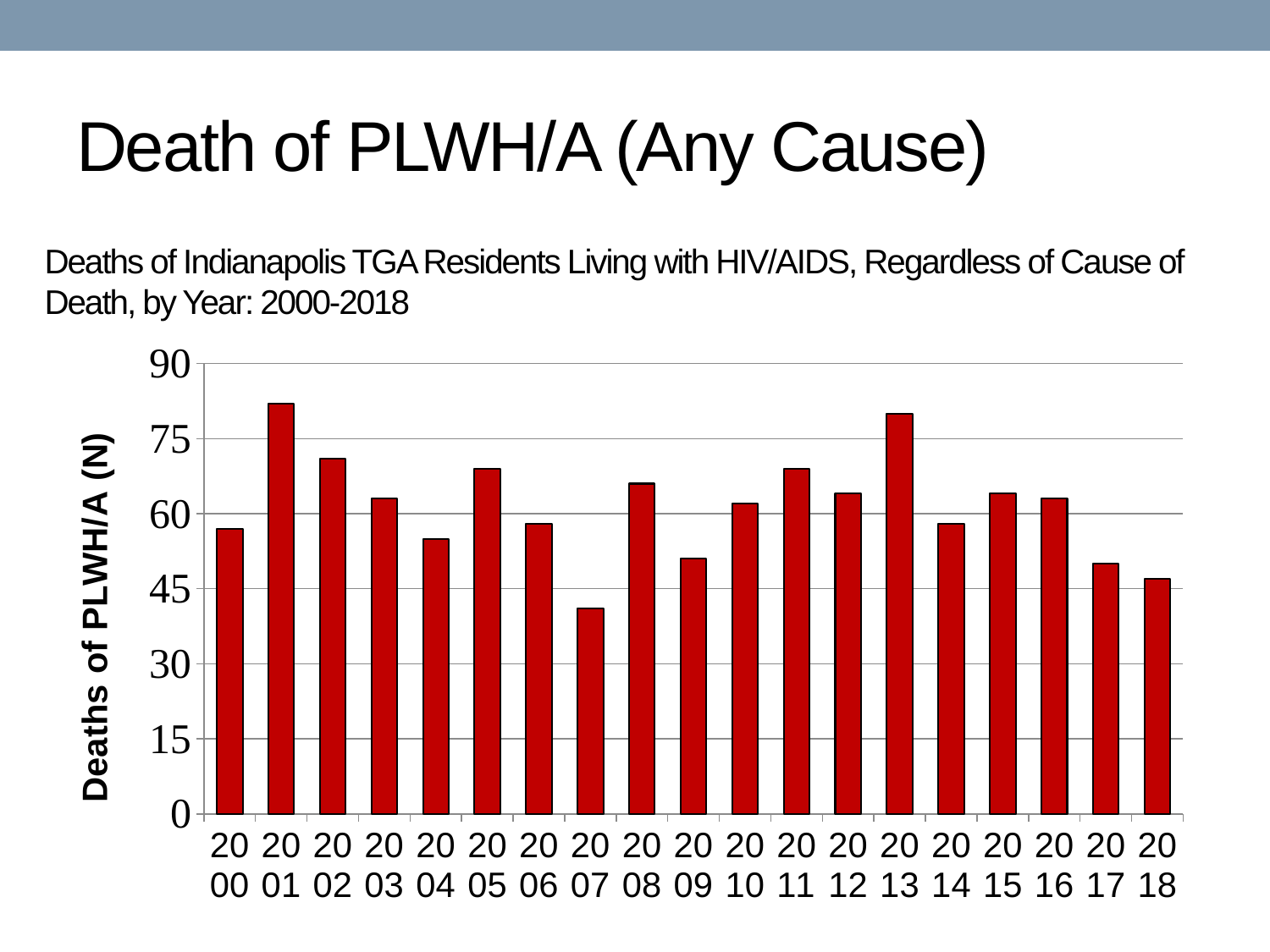
How many years are plotted on the x axis of the chart? 19 Which year has the highest number of deaths of PLWH/A? 2001 Is the value for 2004 greater or less than 60? less Is the value for 2007 greater or less than 45? less Is the value for 2001 greater or less than 75? greater Which year has the lowest number of deaths of PLWH/A? 2007 Which year has more deaths, 2002 or 2004? 2002 Which year has more deaths, 2013 or 2018? 2013 What is the label on the vertical axis of the chart? Deaths of PLWH/A (N) What kind of chart is shown on the slide? bar chart